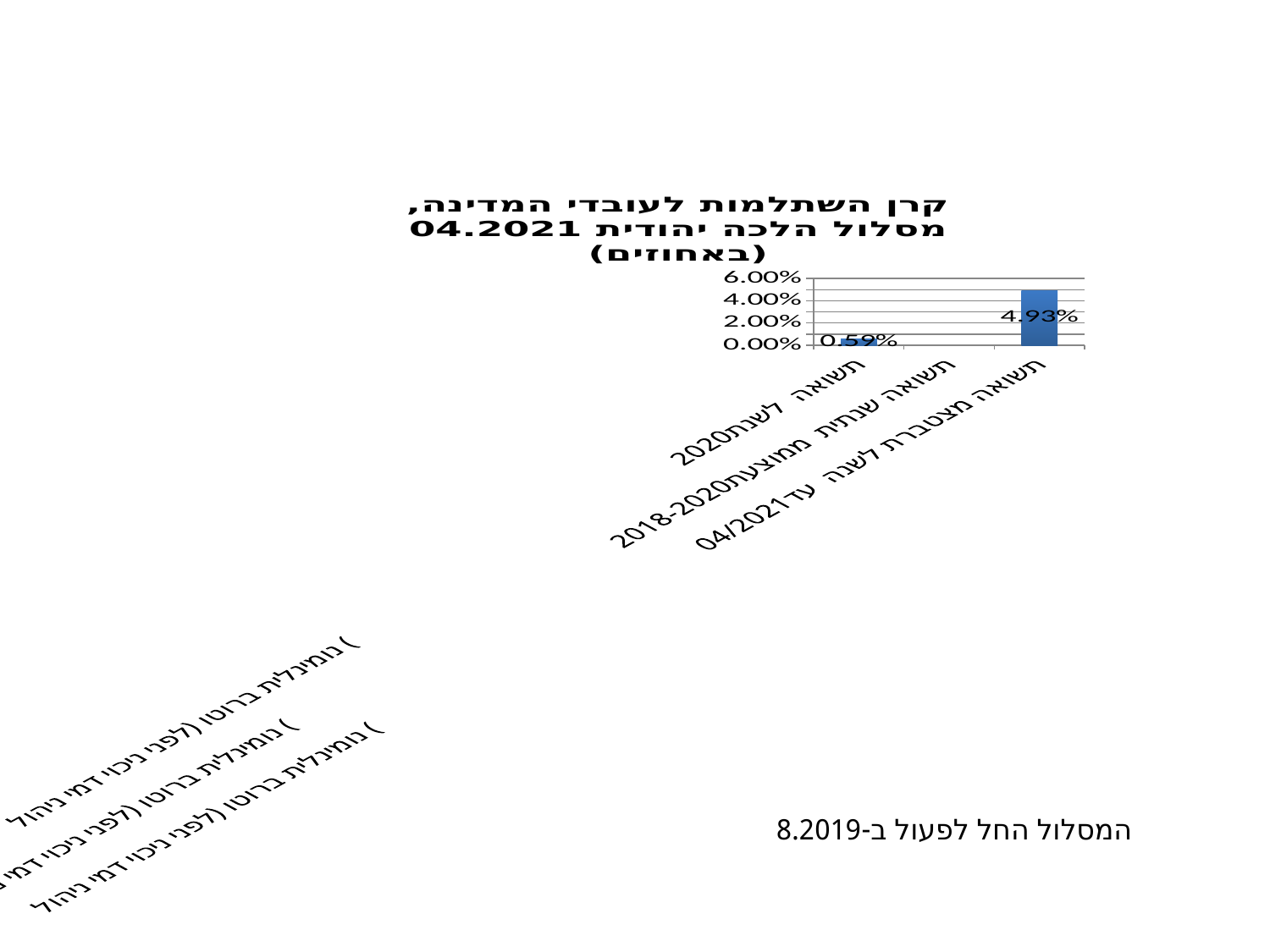
What is the difference between the value for תשואה מצטברת לשנה עד 04/2021 and the value for תשואה לשנת 2020? 4.34% Is the value for תשואה מצטברת לשנה עד 04/2021 greater or less than 4.00%? greater What is the value for תשואה לשנת 2020? 0.59% Is the value for תשואה לשנת 2020 greater or less than 2.00%? less What is the value for תשואה מצטברת לשנה עד 04/2021? 4.93% What is the highest value shown on the y axis of the chart? 6.00% Which is larger: the value for תשואה לשנת 2020 or the value for תשואה מצטברת לשנה עד 04/2021? תשואה מצטברת לשנה עד 04/2021 What kind of chart is shown on the slide? bar chart Which category has the highest value? תשואה מצטברת לשנה עד 04/2021 How many categories are shown on the x axis of the chart? 3 What colour are the bars in the chart? blue